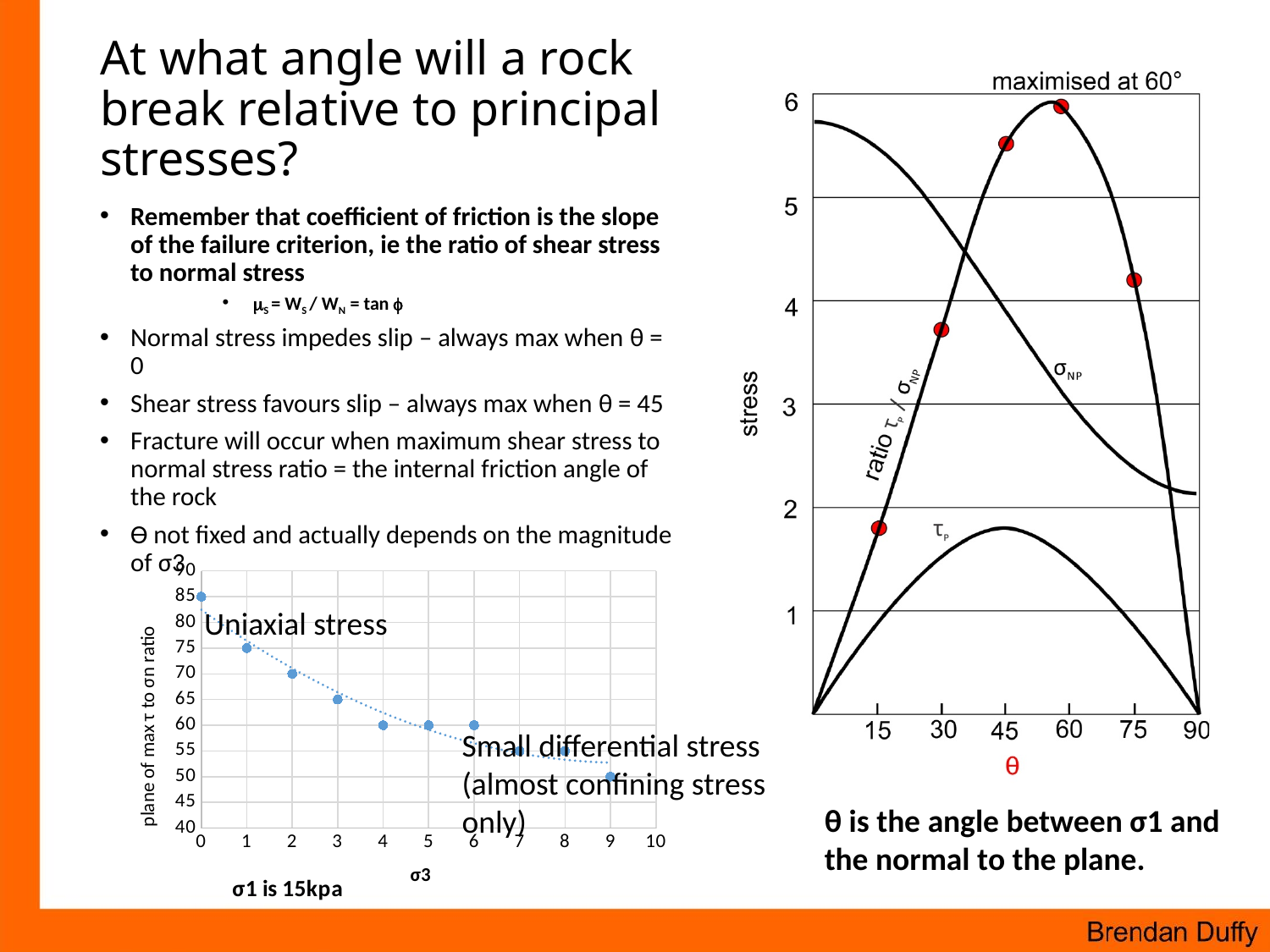
In the bottom-left chart, which has the larger value: σ3 = 1 or σ3 = 2? σ3 = 1 How many data points are plotted in the bottom-left chart? 10 In the bottom-left chart, at which σ3 value is the plotted ratio highest? 0 What kind of chart is the bottom-left chart with σ3 on the x axis? scatter chart In the bottom-left chart, do the values rise or fall as σ3 increases? fall In the bottom-left chart, what is the plane of max τ to σn ratio when σ3 is 0? 85 In the right-hand stress vs θ chart, at what angle θ is the ratio τp/σnp maximised according to the chart's label? 60° In the bottom-left chart, what is the difference between the values at σ3 = 0 and σ3 = 9? 35 In the bottom-left chart, what is the plane of max τ to σn ratio when σ3 is 3? 65 In the right-hand stress vs θ chart, is the value of the ratio τp/σnp at θ = 15 greater or less than 2? less In the bottom-left chart, at which σ3 value is the plotted ratio lowest? 9 In the bottom-left chart, what is the plane of max τ to σn ratio when σ3 is 9? 50